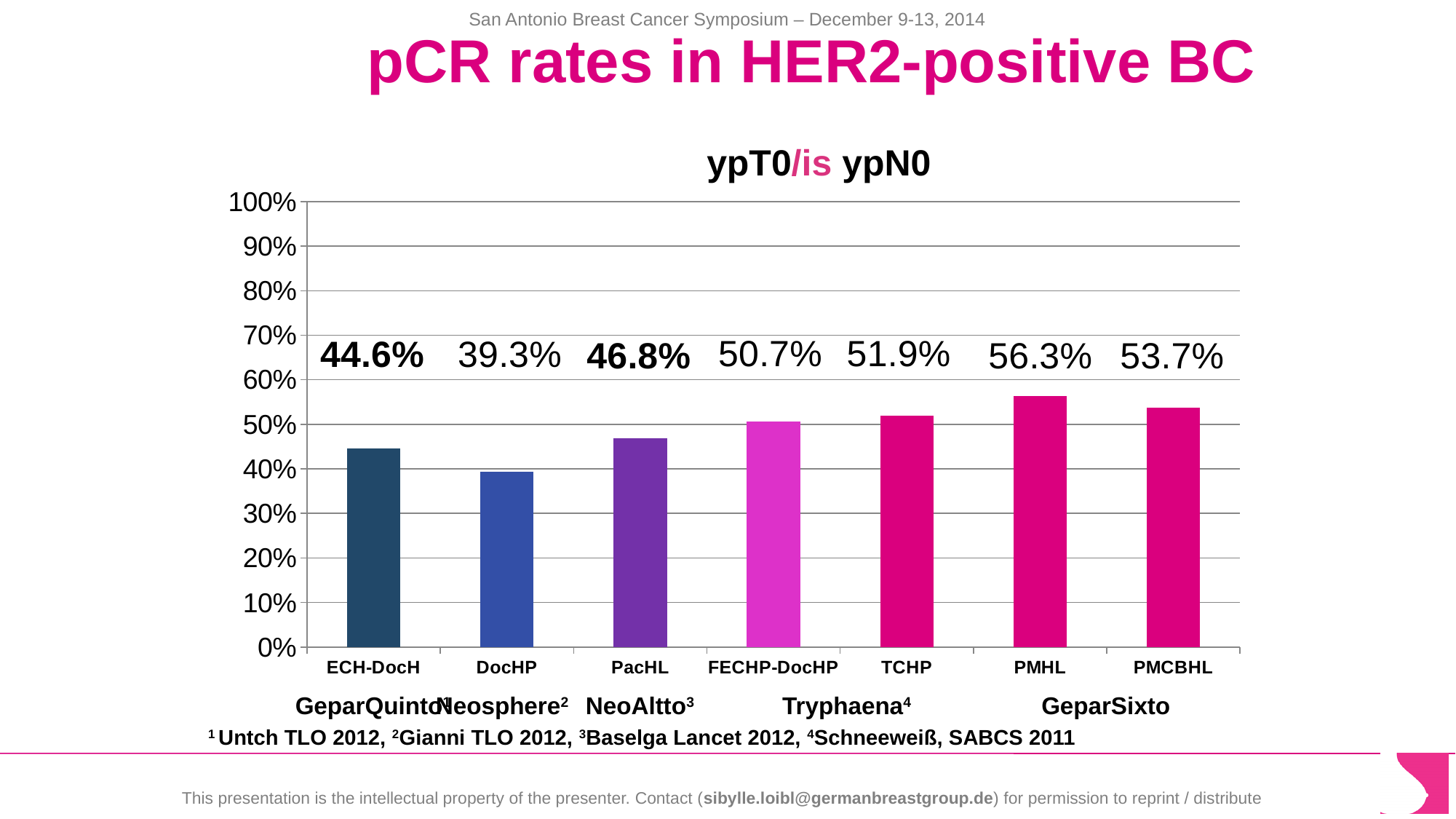
How many regimens are shown in the chart? 7 What type of chart is shown on the slide? Bar chart What is the pCR rate for PMCBHL? 53.7% Which regimen has the lowest pCR rate? DocHP Which regimen has the highest pCR rate? PMHL What is the difference between the pCR rates for PMHL and DocHP? 17.0% What is the difference between the pCR rates for NeoAltto (PacHL) and GeparQuinto (ECH-DocH)? 2.2% Which has a higher pCR rate, FECHP-DocHP or PacHL? FECHP-DocHP What is the pCR rate for TCHP? 51.9% What is the pCR rate for ECH-DocH? 44.6% What is the pCR rate for DocHP? 39.3% What is the title of the chart? ypT0/is ypN0